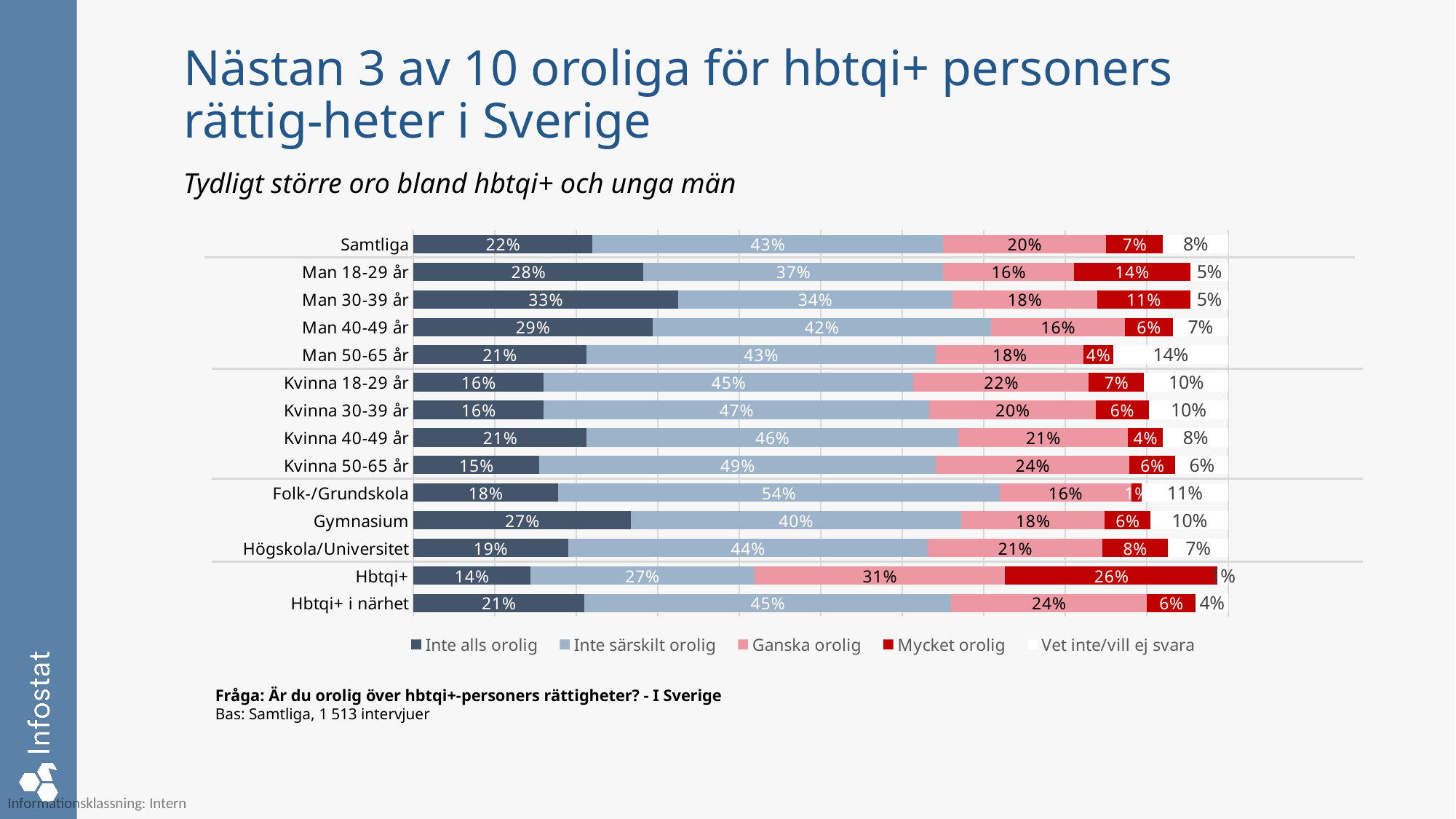
Which has a larger "Inte alls orolig" value, Man 30-39 år or Kvinna 30-39 år? Man 30-39 år Which category has the highest "Mycket orolig" value? Hbtqi+ How many series does the legend list? 5 What is the difference between the "Ganska orolig" values for Hbtqi+ and Samtliga? 11 percentage points Which category has the lowest "Inte alls orolig" value? Hbtqi+ Which category has the highest "Inte särskilt orolig" value? Folk-/Grundskola What is the combined share of "Ganska orolig" and "Mycket orolig" for Kvinna 50-65 år? 30% What percentage of Samtliga answered "Inte alls orolig"? 22% What is the "Vet inte/vill ej svara" value for Man 50-65 år? 14% What is the "Mycket orolig" value for Man 18-29 år? 14% What kind of chart is shown on the slide? Stacked bar chart How many categories are shown on the chart? 14